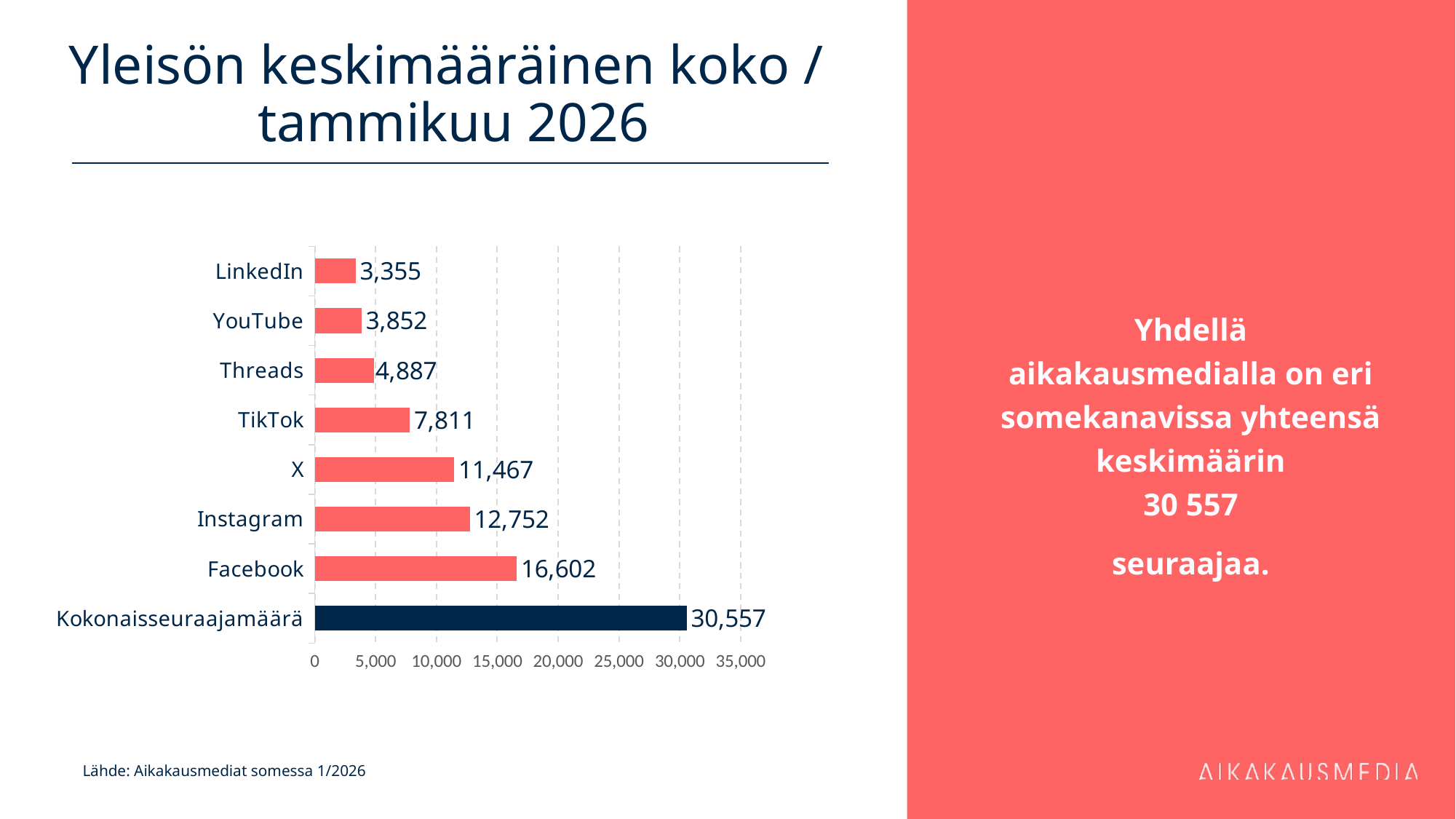
Which bar is shown in a different colour (dark navy) from the others? Kokonaisseuraajamäärä Is the value for X greater or less than 10,000? greater Which individual social media channel (excluding Kokonaisseuraajamäärä) has the highest value? Facebook What is the difference between the values for Instagram and X? 1,285 What is the value for Facebook? 16,602 How many categories are shown on the chart? 8 What is the difference between the values for Facebook and Instagram? 3,850 Which is larger, the value for YouTube or the value for Threads? Threads What is the value for Kokonaisseuraajamäärä? 30,557 What kind of chart is shown on the slide? bar chart What is the value for TikTok? 7,811 Which category has the lowest value? LinkedIn